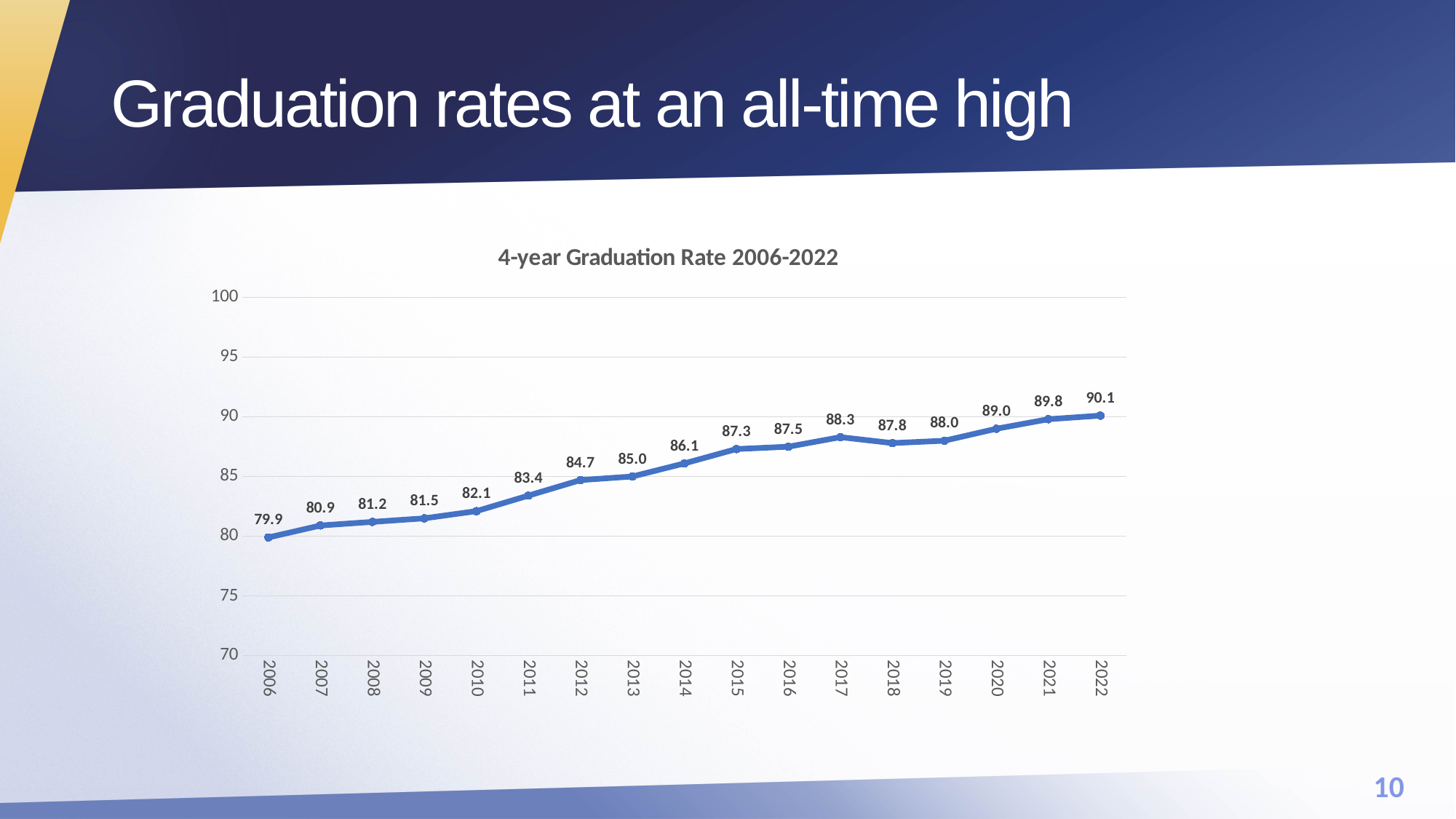
How many years are plotted on the chart? 17 What is the 4-year graduation rate for 2014? 86.1 What kind of chart is shown on the slide? line chart Is the graduation rate for 2012 greater or less than 85? less Which year has a higher graduation rate, 2017 or 2018? 2017 What is the 4-year graduation rate for 2006? 79.9 Does the graduation rate generally rise or fall from 2006 to 2022? rise Which year has the highest 4-year graduation rate? 2022 Which year has the lowest 4-year graduation rate? 2006 What is the difference between the graduation rate in 2022 and in 2006? 10.2 What is the title of the chart? 4-year Graduation Rate 2006-2022 What is the 4-year graduation rate for 2022? 90.1